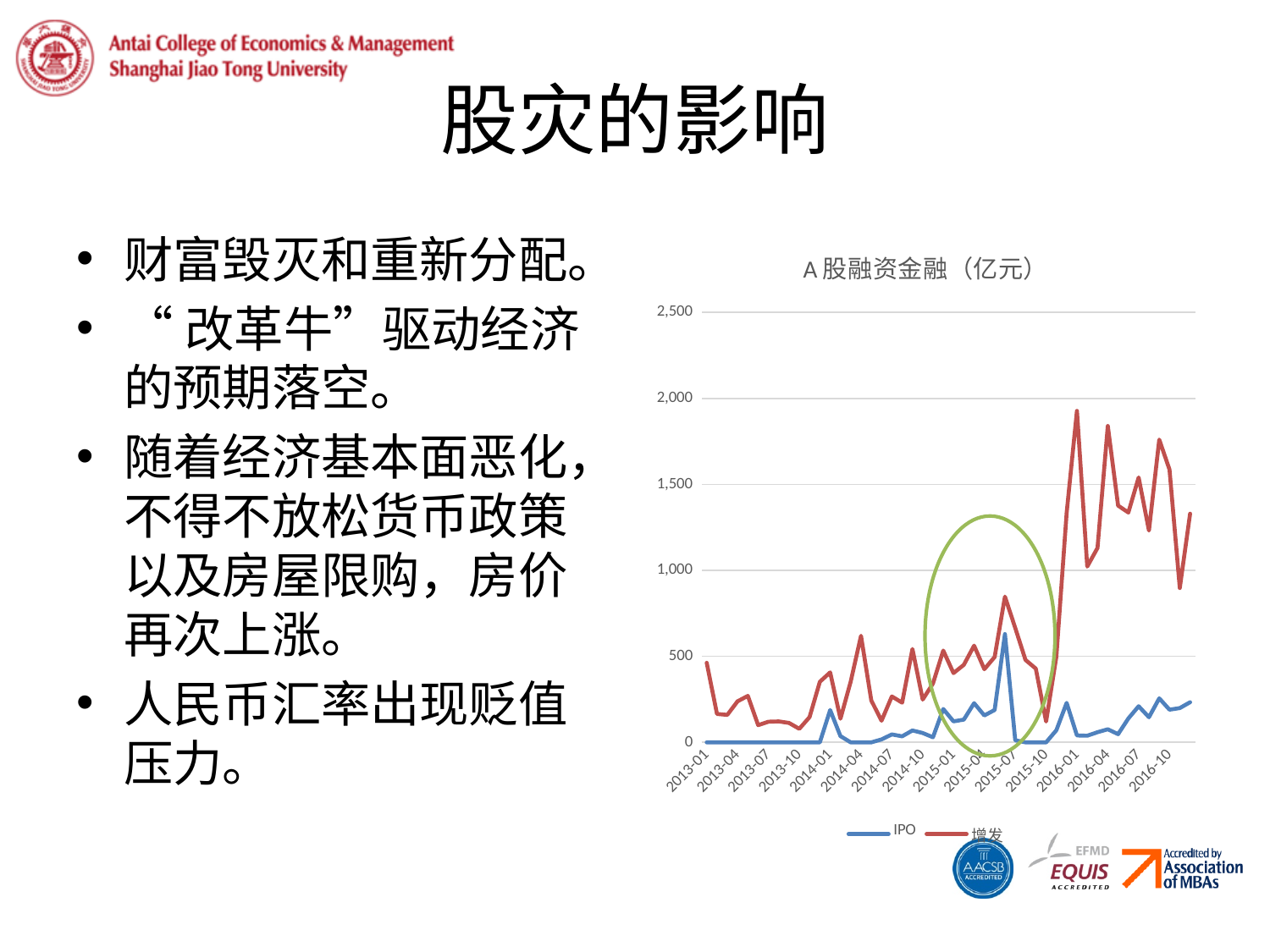
At 2016-01, which series has the larger value, IPO or 增发? 增发 Is the value of 增发 at 2016-10 greater or less than 1,000? greater What kind of chart is shown on the slide? line chart Which series is drawn in red in the chart? 增发 What is the highest value shown on the chart's vertical axis? 2,500 Is the value of IPO at 2016-10 greater or less than 500? less What is the title of the chart? A股融资金融（亿元） How many series does the chart's legend list? 2 Is the value of 增发 at 2016-01 greater or less than 1,500? greater Which series reaches the higher peak value, IPO or 增发? 增发 Does the 增发 series overall rise or fall from 2013-01 to 2016-10? rise